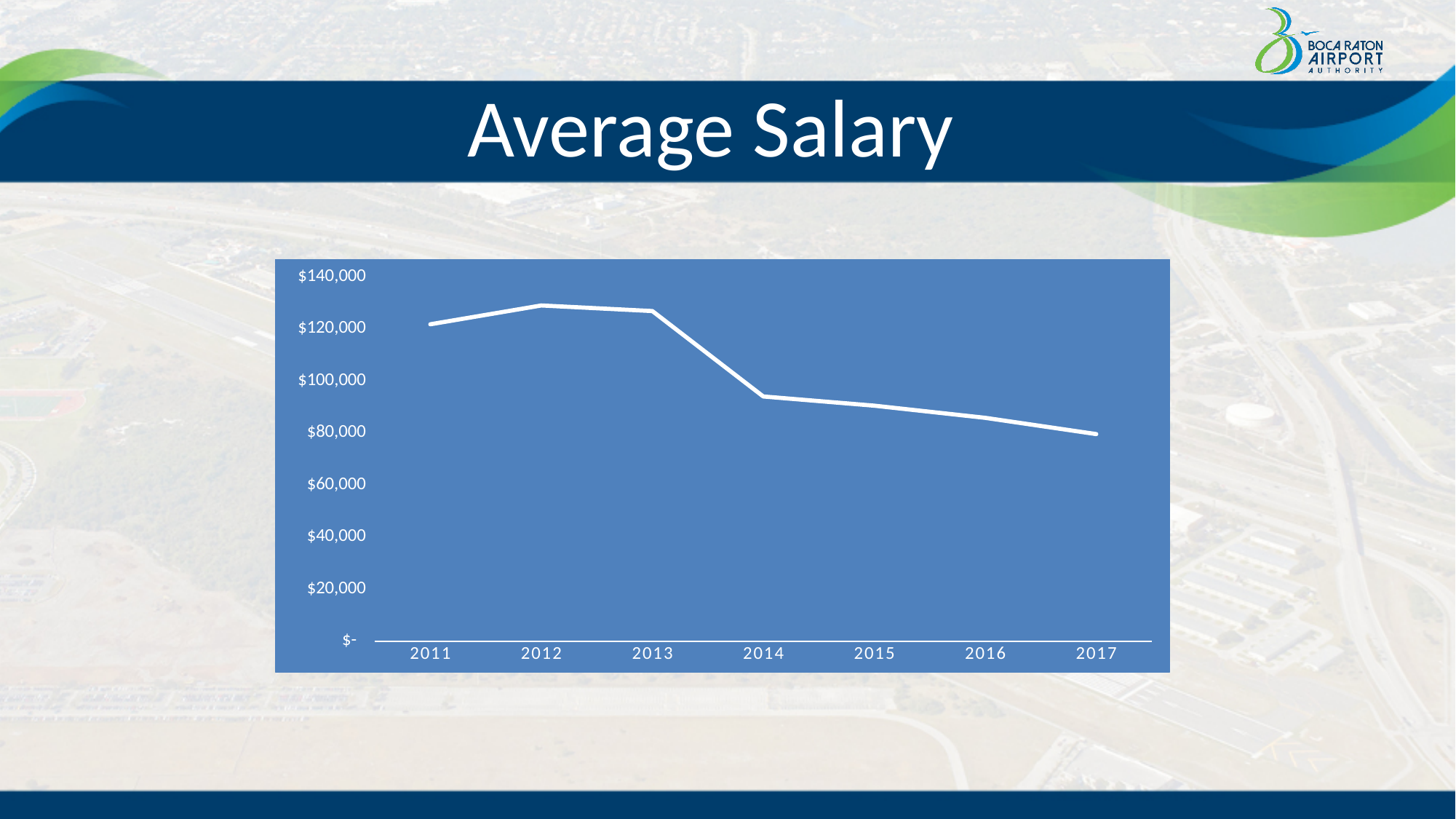
Is the value for 2014 greater or less than $100,000? less Which year has the larger average salary, 2013 or 2014? 2013 Which year has the larger average salary, 2011 or 2017? 2011 What is the title of the chart? Average Salary Is the value for 2011 greater or less than $100,000? greater What kind of chart is shown on the slide? line chart What is the highest value shown on the y axis? $140,000 Is the value for 2012 greater or less than $140,000? less Which year has the lowest average salary? 2017 Does the average salary rise or fall from 2013 to 2017? fall How many years are plotted along the x axis? 7